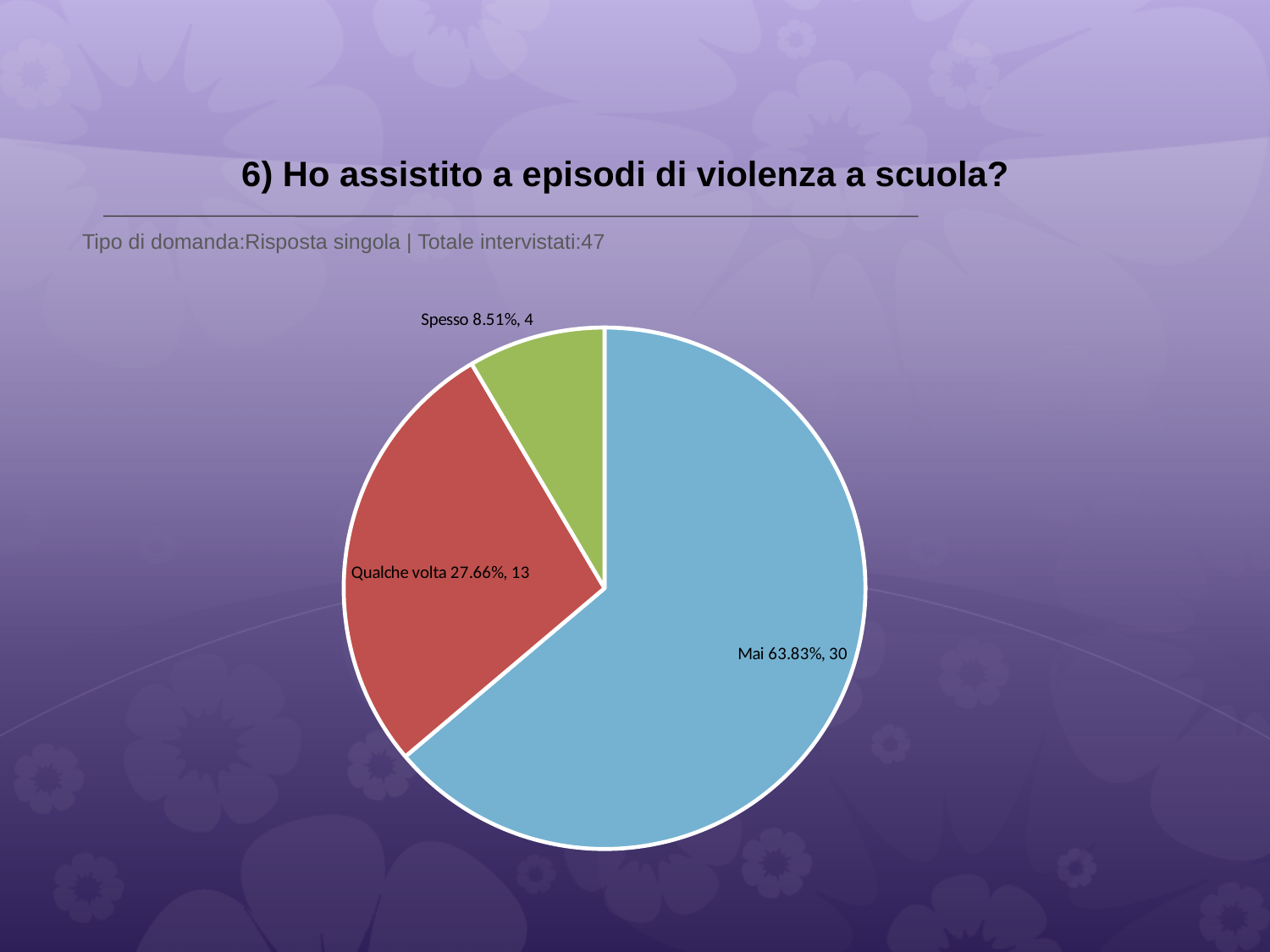
What percentage of respondents answered "Spesso"? 8.51% What share of the pie does the "Qualche volta" slice represent? 27.66% How many more respondents answered "Mai" than "Qualche volta"? 17 What is the title of the slide containing the chart? 6) Ho assistito a episodi di violenza a scuola? How many respondents answered "Qualche volta"? 13 Which answer has the smallest slice of the pie? Spesso How many respondents answered "Mai"? 30 Which answer has the largest slice of the pie? Mai What kind of chart is shown on the slide? pie chart How many slices does the pie chart have? 3 What percentage of respondents answered "Mai"? 63.83% Which slice is larger: "Qualche volta" or "Spesso"? Qualche volta